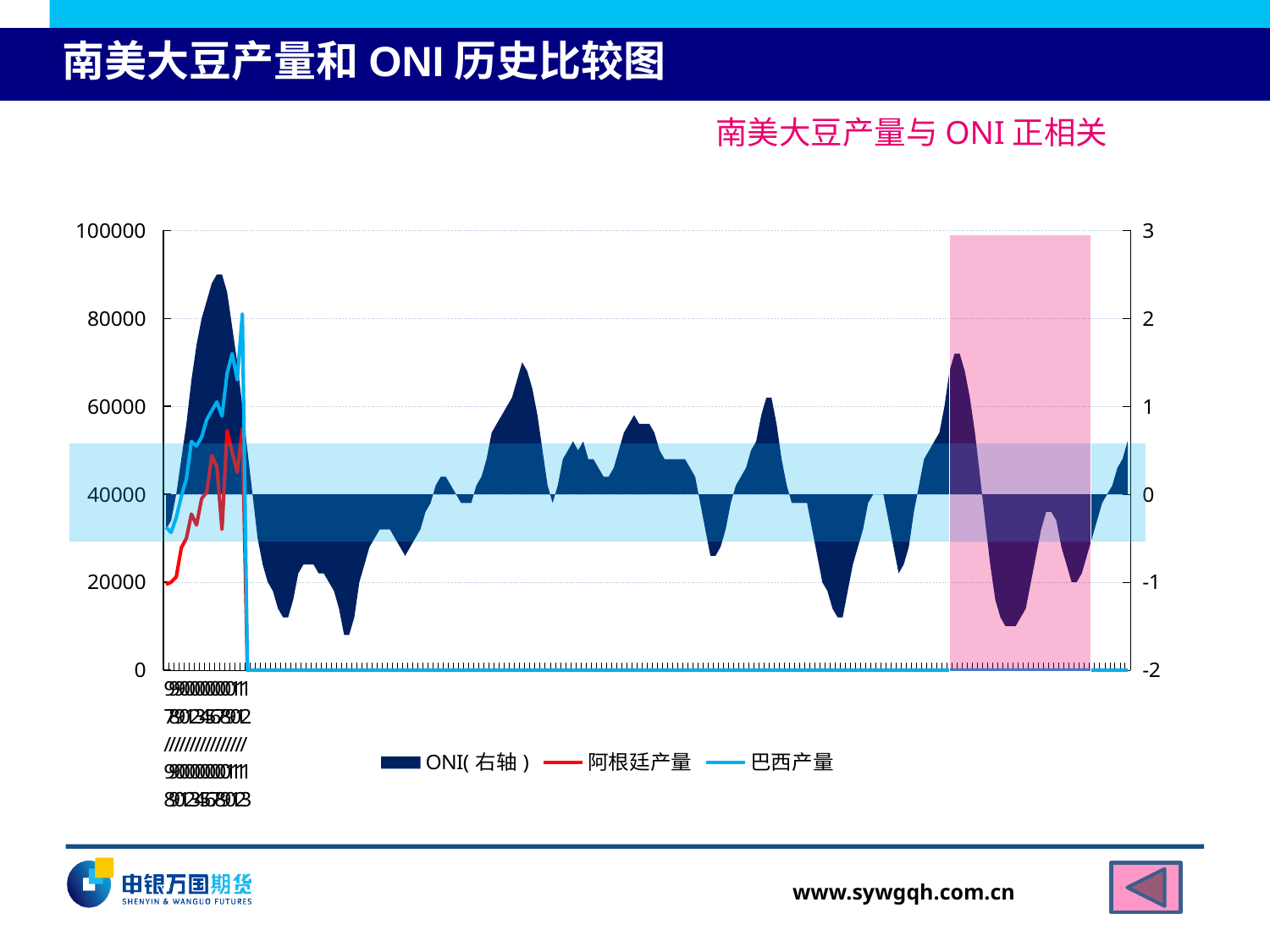
How many series does the chart legend list? 3 What is the lowest value shown on the right vertical axis? -2 What is the highest value shown on the right vertical axis? 3 Is the peak value of the 巴西产量 line greater or less than 60000? greater What is the title of the slide containing the chart? 南美大豆产量和 ONI 历史比较图 Which series is drawn as a filled area rather than a line? ONI( 右轴 ) Which line reaches a higher peak, 巴西产量 or 阿根廷产量? 巴西产量 Which series in the legend is plotted on the right axis? ONI( 右轴 ) What is the highest value shown on the left vertical axis? 100000 Is the peak value of the 阿根廷产量 line greater or less than 60000? less Is the highest value of the ONI series greater or less than 1 on the right axis? greater